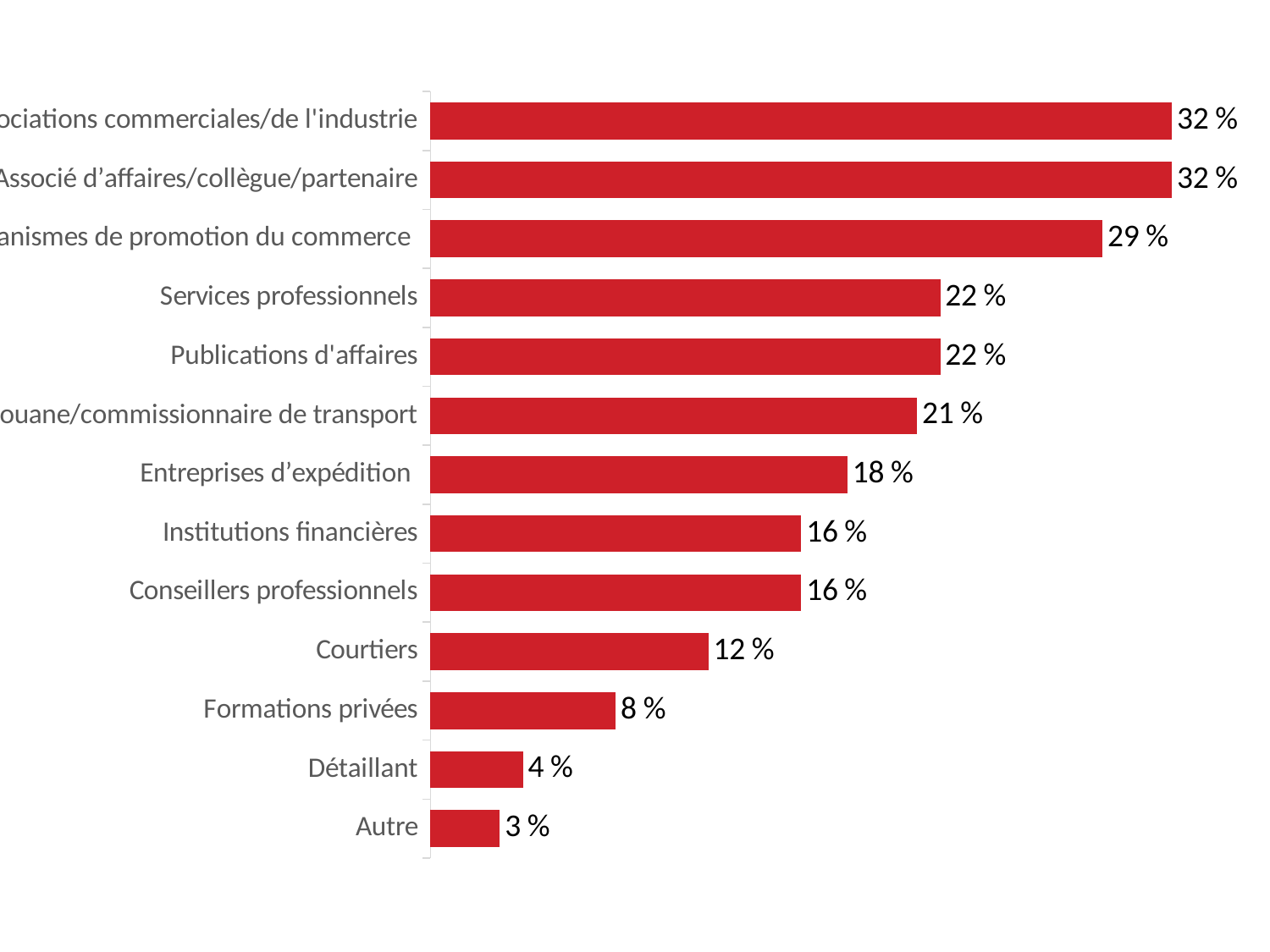
How many categories are plotted in the chart? 13 Which is larger, the value for Conseillers professionnels or the value for Formations privées? Conseillers professionnels What is the difference between the values for Courtiers and Autre? 9 % What is the value for Détaillant? 4 % What is the value for Entreprises d’expédition? 18 % What colour are the bars in the chart? red What is the difference between the values for Publications d'affaires and Institutions financières? 6 % What type of chart is shown on the slide? bar chart What is the value for Services professionnels? 22 % What is the value for Formations privées? 8 % Which category has the lowest value? Autre What is the value for Courtiers? 12 %